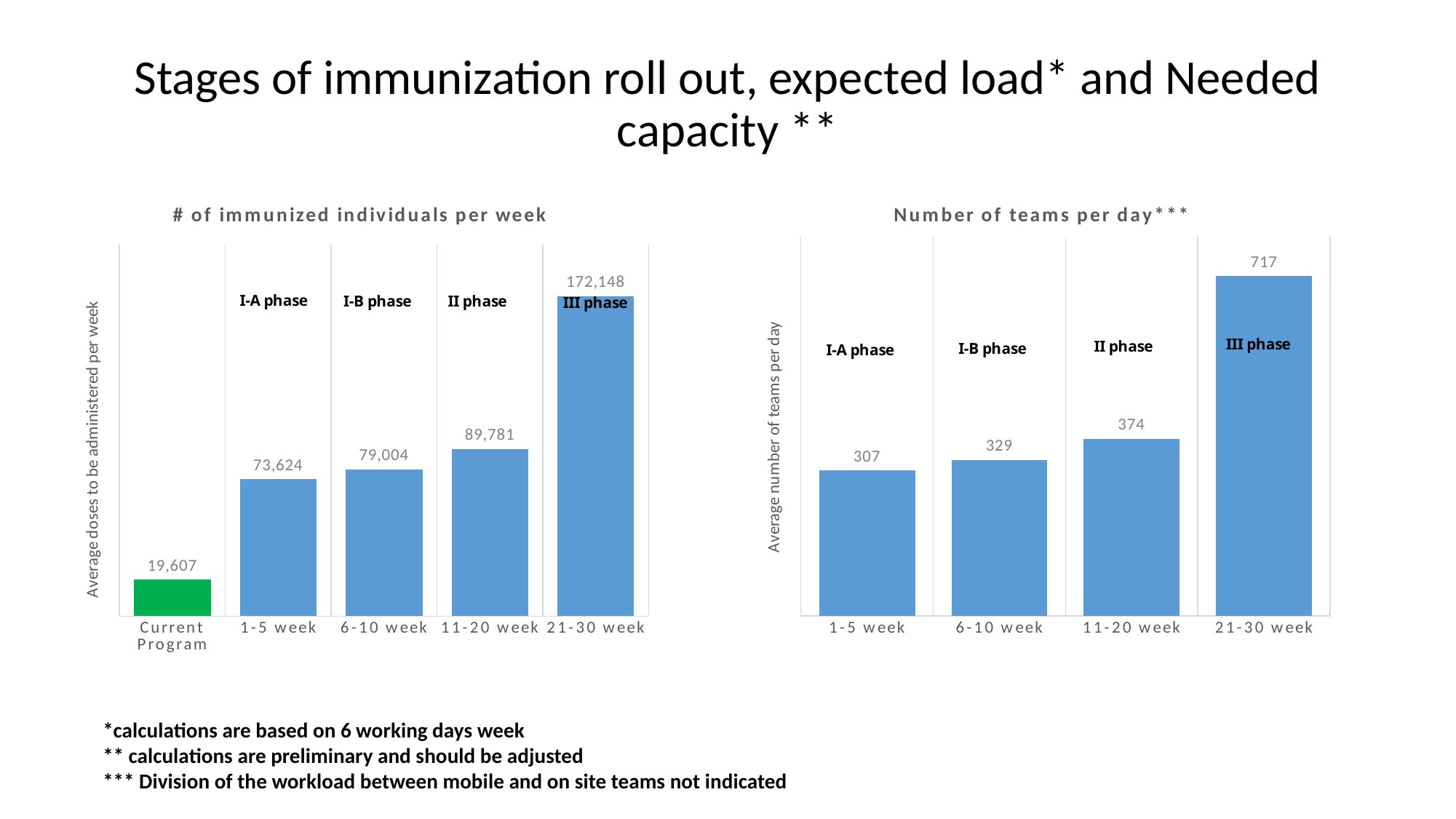
In the 'Number of teams per day' chart, do the values rise or fall from 1-5 week to 21-30 week? Rise How many bars are in the '# of immunized individuals per week' chart? 5 In the 'Number of teams per day' chart, which category has the lowest value? 1-5 week In the '# of immunized individuals per week' chart, what is the value for 11-20 week? 89,781 In the '# of immunized individuals per week' chart, what is the value for the Current Program? 19,607 In the 'Number of teams per day' chart, what is the value for 6-10 week? 329 In the '# of immunized individuals per week' chart, what is the difference between the values for 6-10 week and 1-5 week? 5,380 What type of chart is the 'Number of teams per day' chart? Bar chart In the 'Number of teams per day' chart, what is the value for 21-30 week? 717 In the 'Number of teams per day' chart, what is the difference between the values for 21-30 week and 11-20 week? 343 In the '# of immunized individuals per week' chart, which is larger: the value for 1-5 week or the value for 11-20 week? 11-20 week In the '# of immunized individuals per week' chart, which category has the highest value? 21-30 week